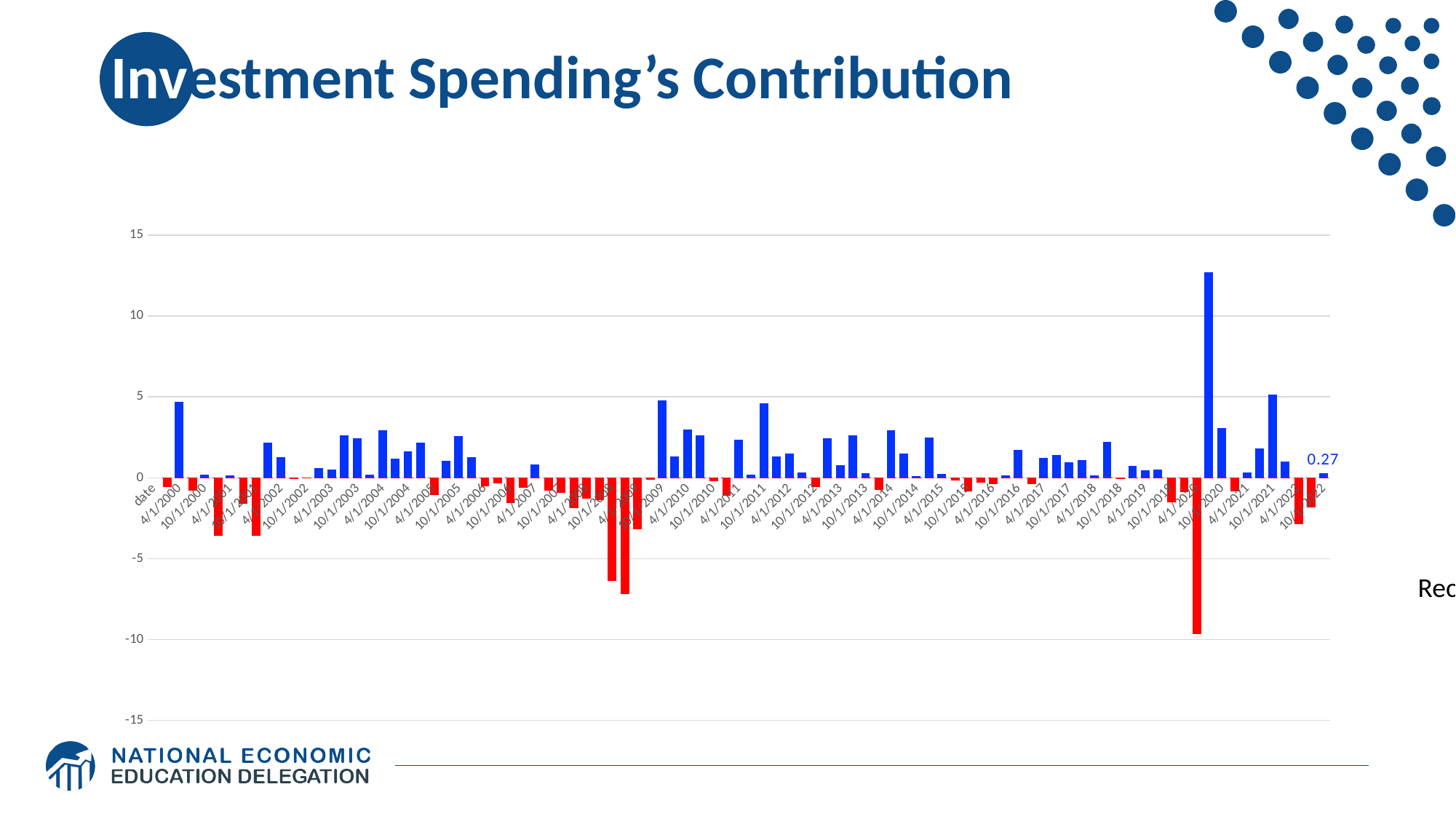
What kind of chart is shown on the slide? bar chart Is the value for 4/1/2009 greater or less than 0? less What is the only data label value printed on the chart, shown at the far right? 0.27 Is the value for 4/1/2000 greater or less than 0? greater Which is larger, the value for 4/1/2000 or the value for 10/1/2000? 4/1/2000 What is the title of the slide containing the chart? Investment Spending's Contribution What is the highest value shown on the vertical axis? 15 Is the value for 4/1/2000 greater or less than 10? less What is the lowest value shown on the vertical axis? -15